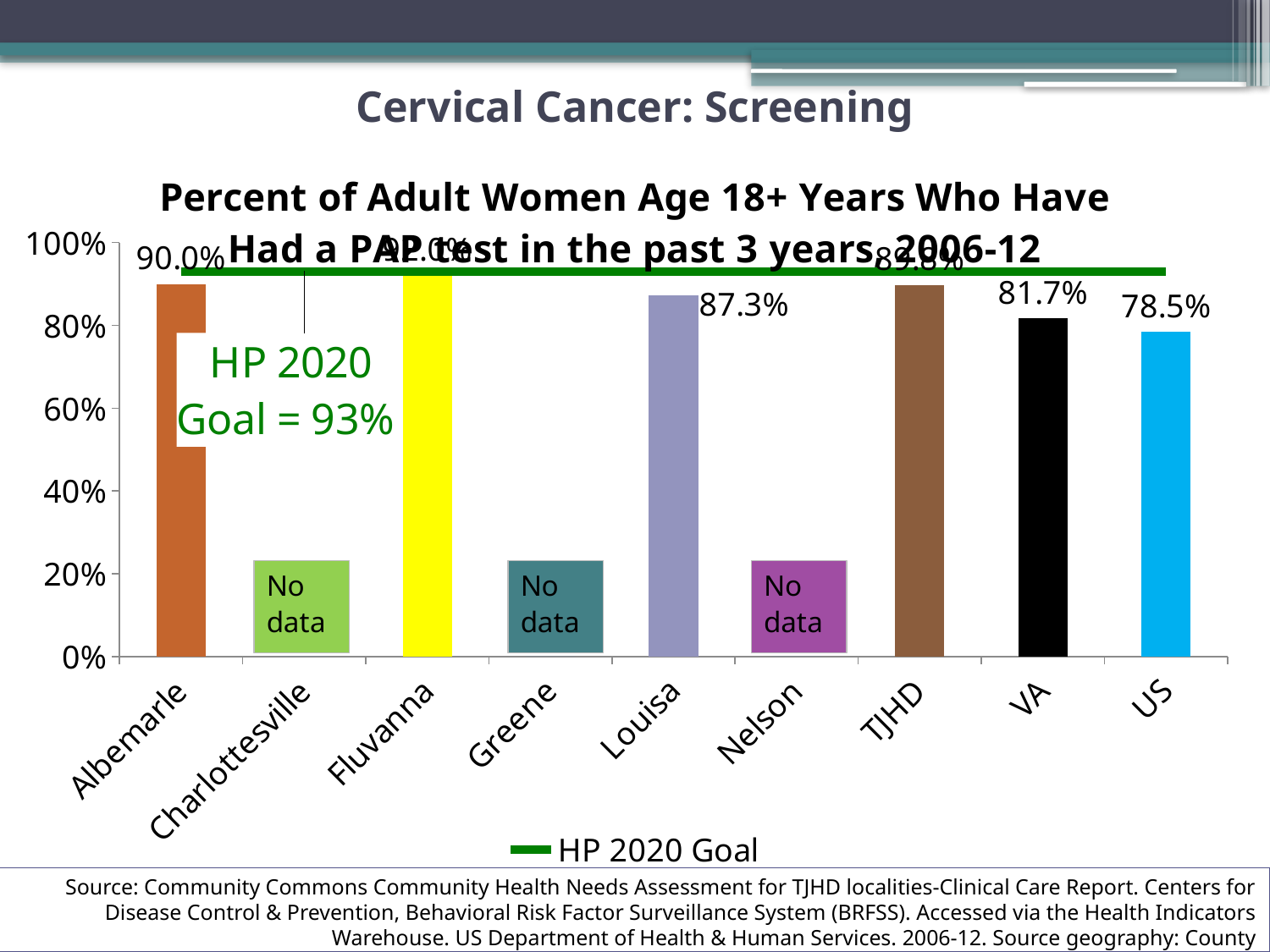
What is the HP 2020 Goal shown on the chart? 93% What is the value for Albemarle? 90.0% Which is larger, the value for Albemarle or the value for Louisa? Albemarle Is the value for TJHD greater or less than 80%? greater How many categories are shown on the x axis? 9 What is the difference between the values for VA and US? 3.2 percentage points Among the categories with data, which has the lowest value? US What kind of chart is this? bar chart What is the value for VA? 81.7% Which category has the highest bar? Fluvanna What is the value for US? 78.5% What is the value for Louisa? 87.3%